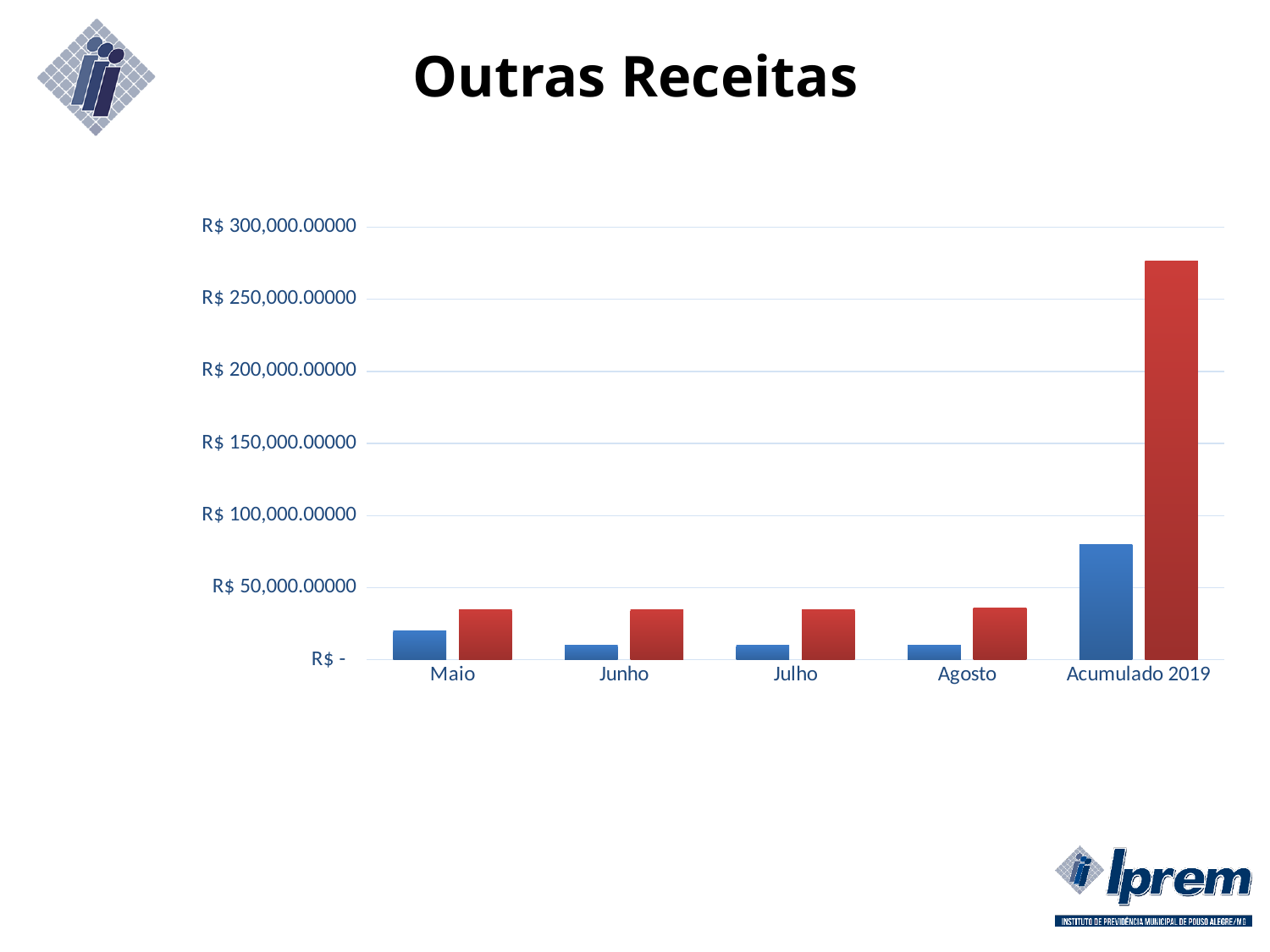
Is the value of the blue bar for Acumulado 2019 greater or less than R$ 50,000.00000? greater What is the title of the chart? Outras Receitas How many categories are shown on the x axis of the chart? 5 Which category has the tallest bar in the chart? Acumulado 2019 What kind of chart is shown on the slide? bar chart Is the value of the blue bar for Acumulado 2019 greater or less than R$ 100,000.00000? less Which blue bar is taller, Maio or Junho? Maio Is the value of the red bar for Acumulado 2019 greater or less than R$ 300,000.00000? less How many bars are plotted for each category in the chart? 2 For Maio, which bar is taller, the blue bar or the red bar? the red bar